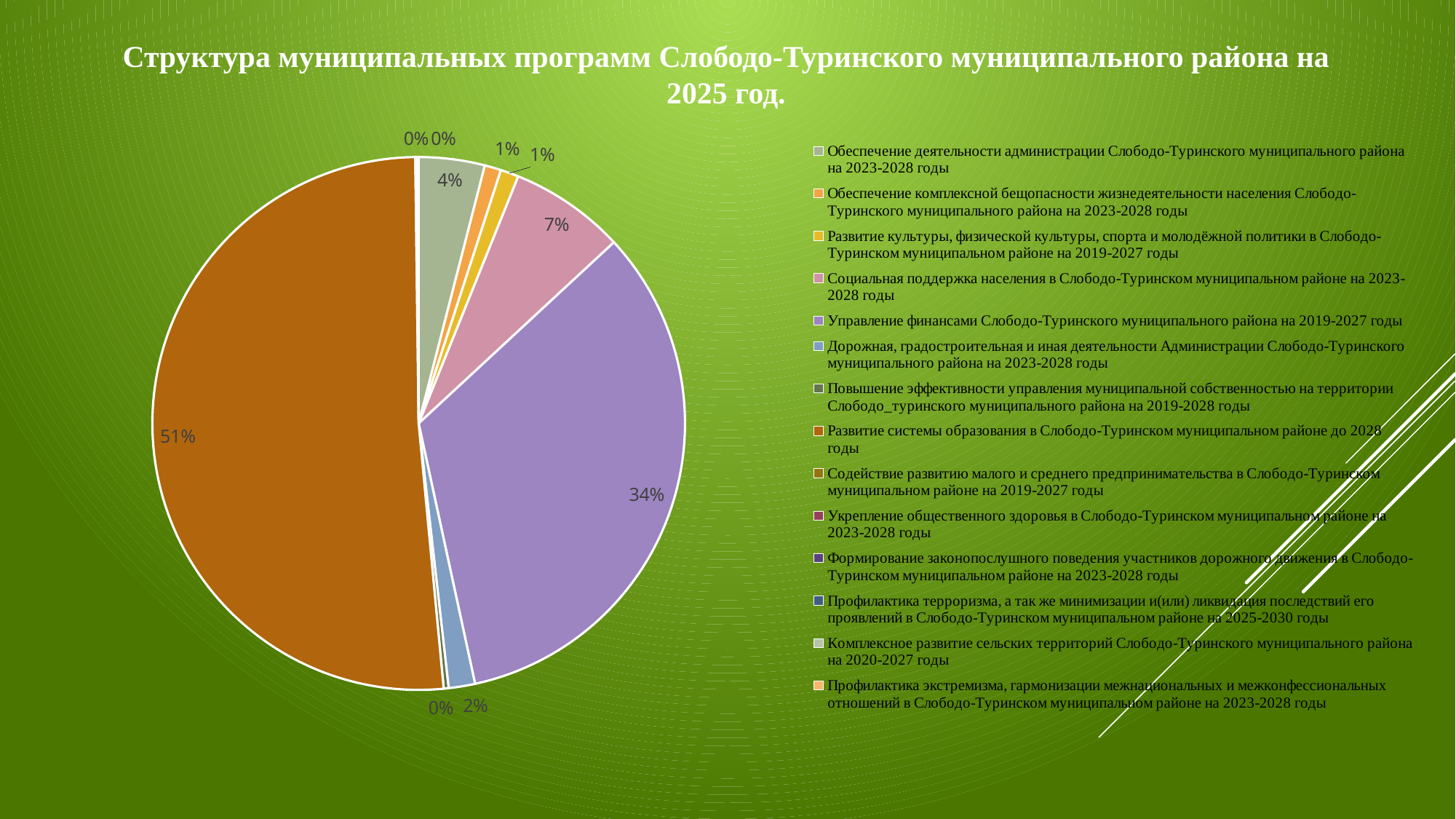
What is the difference in percentage points between the education program (51%) and the finance management program (34%)? 17 What kind of chart is shown on the slide? pie chart What share of the pie does the program 'Развитие системы образования в Слободо-Туринском муниципальном районе до 2028 годы' have? 51% What share of the pie does the program 'Обеспечение деятельности администрации Слободо-Туринского муниципального района на 2023-2028 годы' have? 4% What share of the pie does the program 'Дорожная, градостроительная и иная деятельности Администрации Слободо-Туринского муниципального района на 2023-2028 годы' have? 2% What colour is the slice for 'Управление финансами Слободо-Туринского муниципального района на 2019-2027 годы'? purple What is the title of the chart? Структура муниципальных программ Слободо-Туринского муниципального района на 2025 год. Which is larger: the share for 'Социальная поддержка населения' or the share for 'Обеспечение деятельности администрации'? Социальная поддержка населения Which program has the largest share of the pie? Развитие системы образования в Слободо-Туринском муниципальном районе до 2028 годы How many programs are listed in the legend? 14